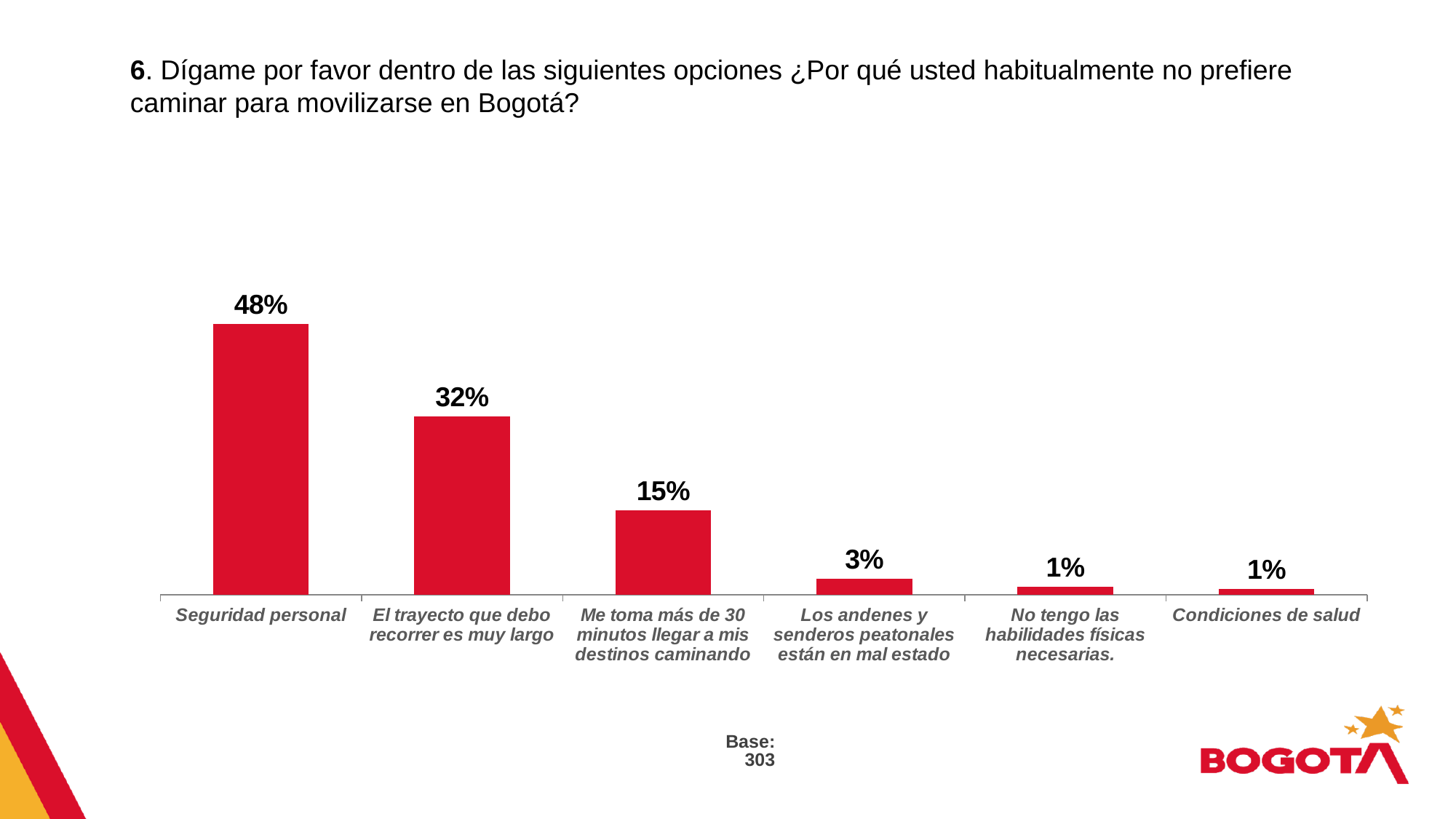
What is the difference between the values for "Seguridad personal" and "El trayecto que debo recorrer es muy largo"? 16% What is the value for "Seguridad personal"? 48% What is the value for "Condiciones de salud"? 1% How many categories are shown in the chart? 6 Which category has the highest value? Seguridad personal What kind of chart is shown on the slide? Bar chart What is the value for "El trayecto que debo recorrer es muy largo"? 32% What is the value for "Los andenes y senderos peatonales están en mal estado"? 3% Do the values rise or fall from left to right across the categories? Fall What is the difference between the values for "El trayecto que debo recorrer es muy largo" and "Me toma más de 30 minutos llegar a mis destinos caminando"? 17% Which is larger, the value for "Me toma más de 30 minutos llegar a mis destinos caminando" or the value for "Los andenes y senderos peatonales están en mal estado"? Me toma más de 30 minutos llegar a mis destinos caminando What is the value for "Me toma más de 30 minutos llegar a mis destinos caminando"? 15%